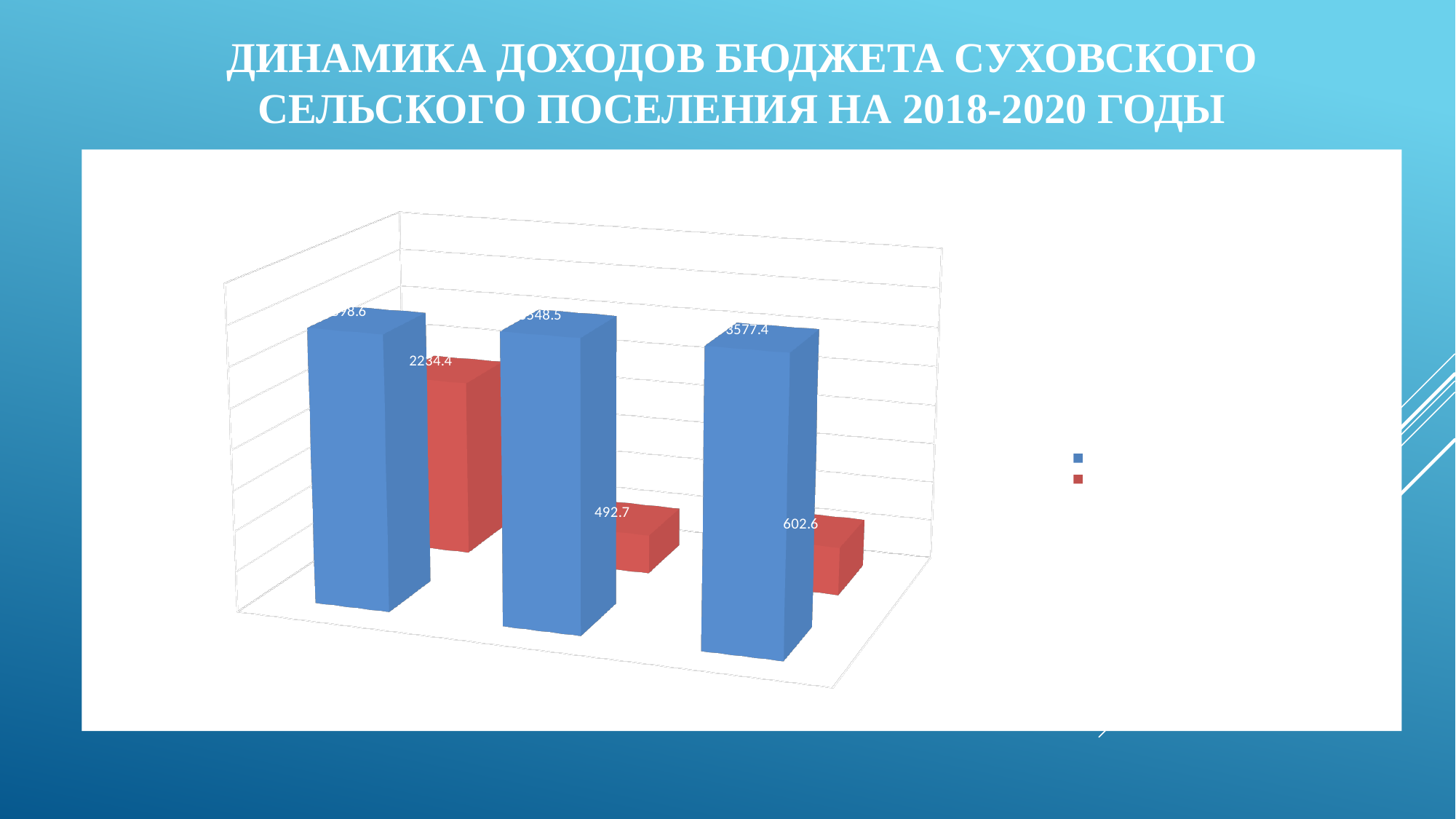
Which group has the highest red bar? the first group What is the difference between the blue bar and the red bar in the third group? 2974.8 How many series does the legend list? 2 In the third group, which is larger, the blue bar or the red bar? the blue bar What is the value of the red bar in the first group? 2234.4 What is the difference between the red bar in the third group and the red bar in the second group? 109.9 What is the value of the red bar in the third group? 602.6 What is the value of the blue bar in the third group? 3577.4 Which group has the lowest red bar? the second group How many groups of bars are plotted in the chart? 3 What kind of chart is shown on the slide? bar chart What is the value of the red bar in the second group? 492.7